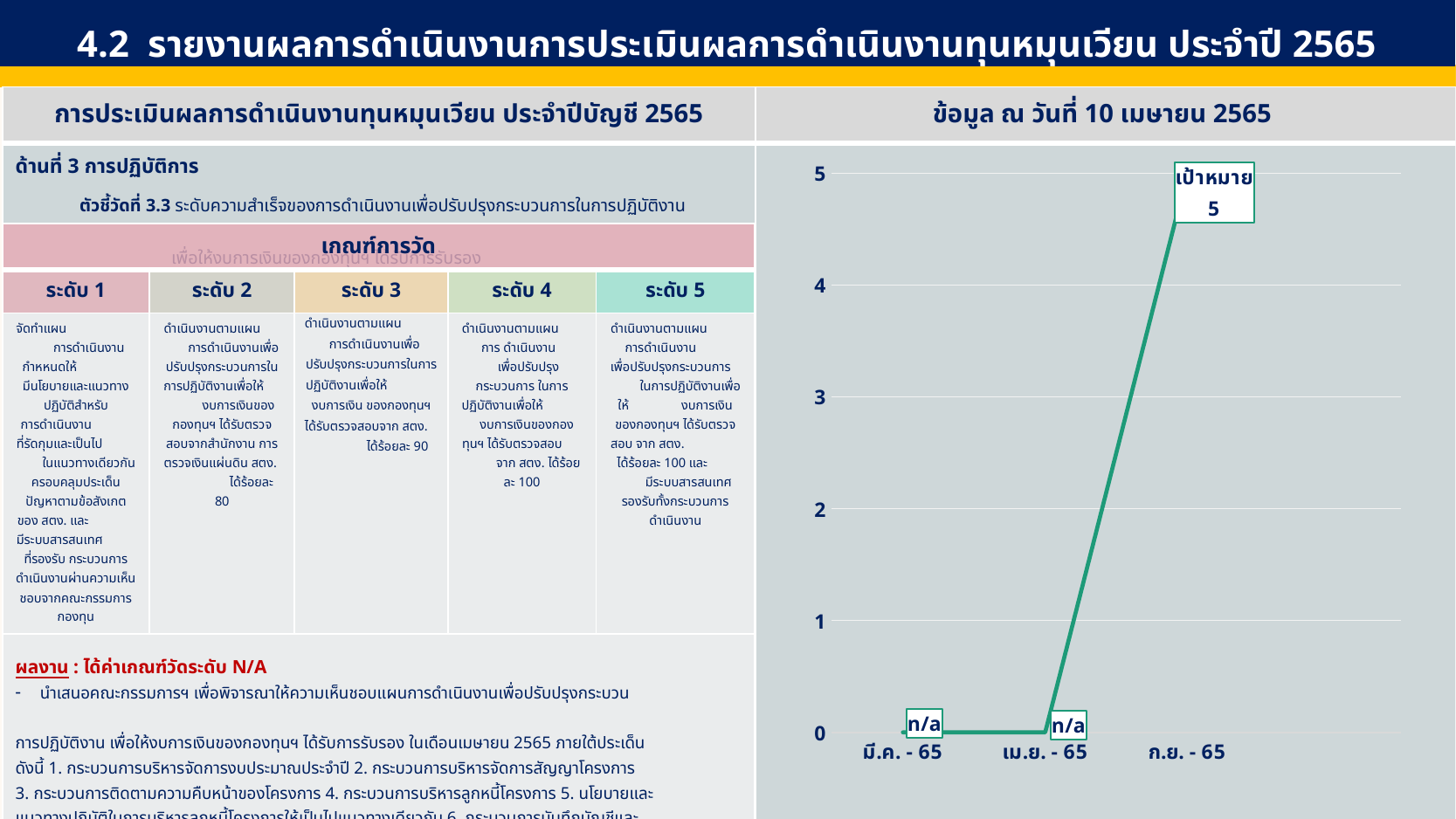
What word appears in the label box above the data point at ก.ย. - 65? เป้าหมาย What is the first category on the x axis of the chart? มี.ค. - 65 What kind of chart is shown on the right side of the slide? line chart What label is shown for the data point at เม.ย. - 65? n/a What label is shown for the data point at มี.ค. - 65? n/a Which x-axis category has the highest plotted value on the chart? ก.ย. - 65 How many categories are shown on the x axis of the chart? 3 What value is labelled at ก.ย. - 65 on the chart? 5 Is the value plotted at เม.ย. - 65 greater or less than 1? less Is the value plotted at ก.ย. - 65 greater or less than 4? greater What is the highest tick value shown on the y axis of the chart? 5 Does the line on the chart rise or fall from เม.ย. - 65 to ก.ย. - 65? rise